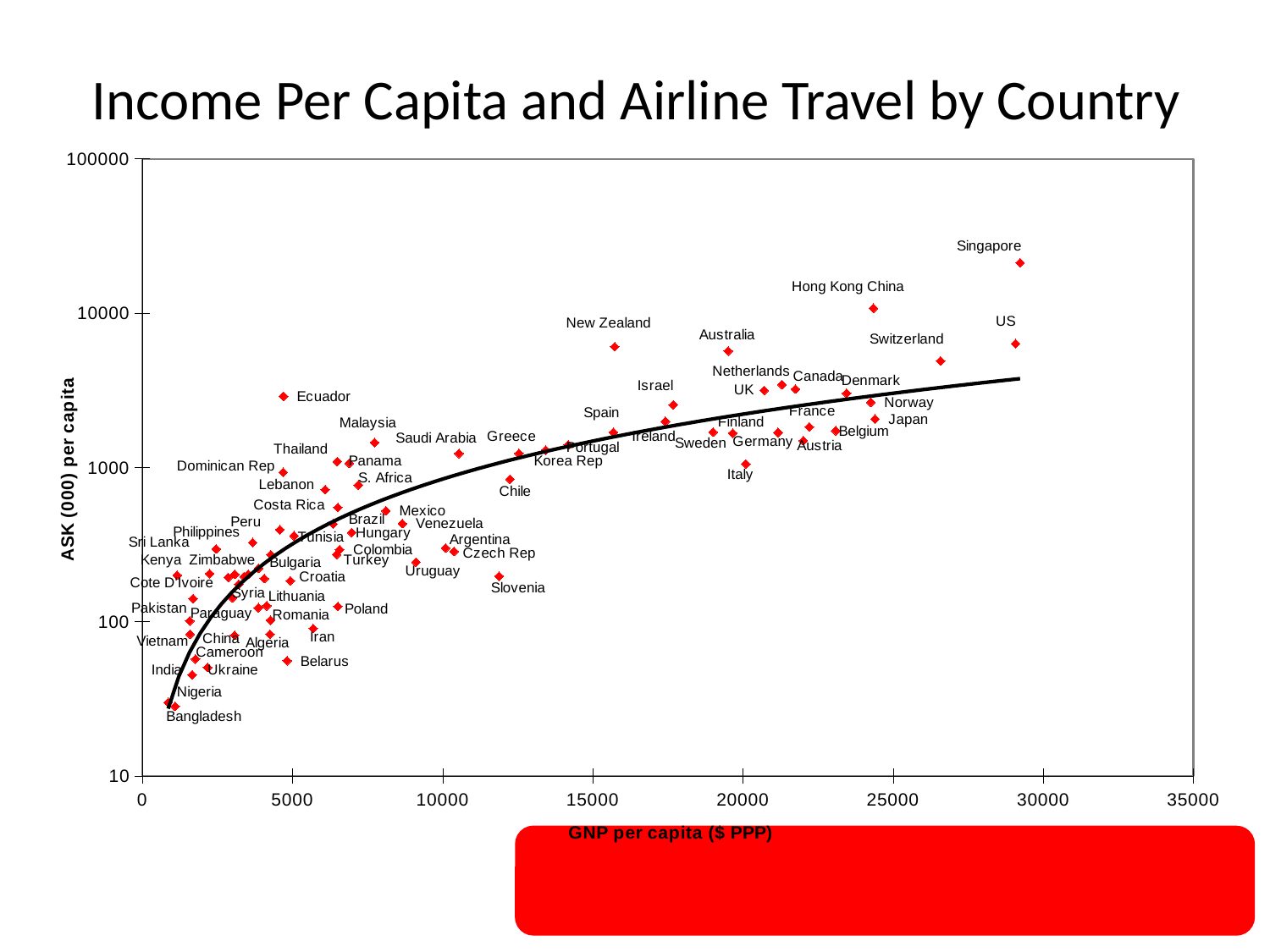
What is the title of the chart? Income Per Capita and Airline Travel by Country Is the ASK (000) per capita for Chile greater or less than 1000? less Which has a higher ASK (000) per capita, Hong Kong China or Switzerland? Hong Kong China Which country has the highest ASK (000) per capita? Singapore Is the ASK (000) per capita for Singapore greater or less than 10000? greater Which country has the highest GNP per capita? Singapore Does ASK (000) per capita generally rise or fall as GNP per capita increases along the x axis? rise Is the GNP per capita for Greece greater or less than 10000? greater What is the label of the vertical axis? ASK (000) per capita What kind of chart is shown on the slide? scatter chart Which country has the lowest ASK (000) per capita? Bangladesh